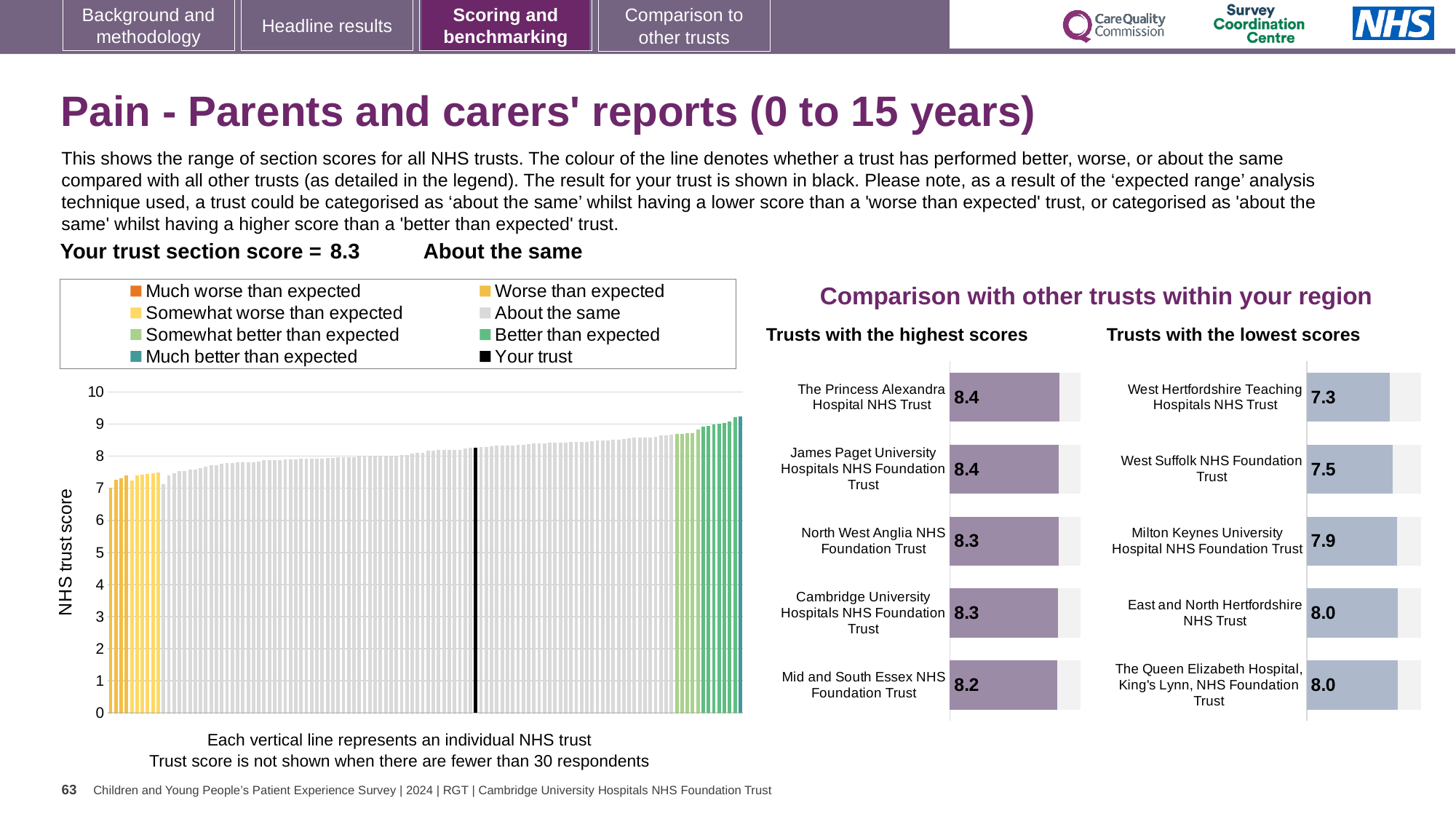
In the large chart on the left, how many entries does the legend list? 8 In the 'Trusts with the highest scores' chart, what is the difference between the scores of The Princess Alexandra Hospital NHS Trust and Mid and South Essex NHS Foundation Trust? 0.2 In the 'Trusts with the lowest scores' chart, which has the higher score: West Suffolk NHS Foundation Trust or Milton Keynes University Hospital NHS Foundation Trust? Milton Keynes University Hospital NHS Foundation Trust In the 'Trusts with the highest scores' chart, what is the score for North West Anglia NHS Foundation Trust? 8.3 In the 'Trusts with the lowest scores' chart, which trust has the lowest score? West Hertfordshire Teaching Hospitals NHS Trust What kind of chart is the large chart on the left showing NHS trust scores? bar chart In the large chart on the left, is the value of the lowest yellow bar greater or less than 8? less In the 'Trusts with the lowest scores' chart, what is the score for West Hertfordshire Teaching Hospitals NHS Trust? 7.3 In the large chart on the left, what is the label on the vertical axis? NHS trust score In the 'Trusts with the highest scores' chart, which trust has the lowest score? Mid and South Essex NHS Foundation Trust In the 'Trusts with the lowest scores' chart, what is the difference between the scores of Milton Keynes University Hospital NHS Foundation Trust and West Hertfordshire Teaching Hospitals NHS Trust? 0.6 In the 'Trusts with the highest scores' chart, how many trusts are shown? 5